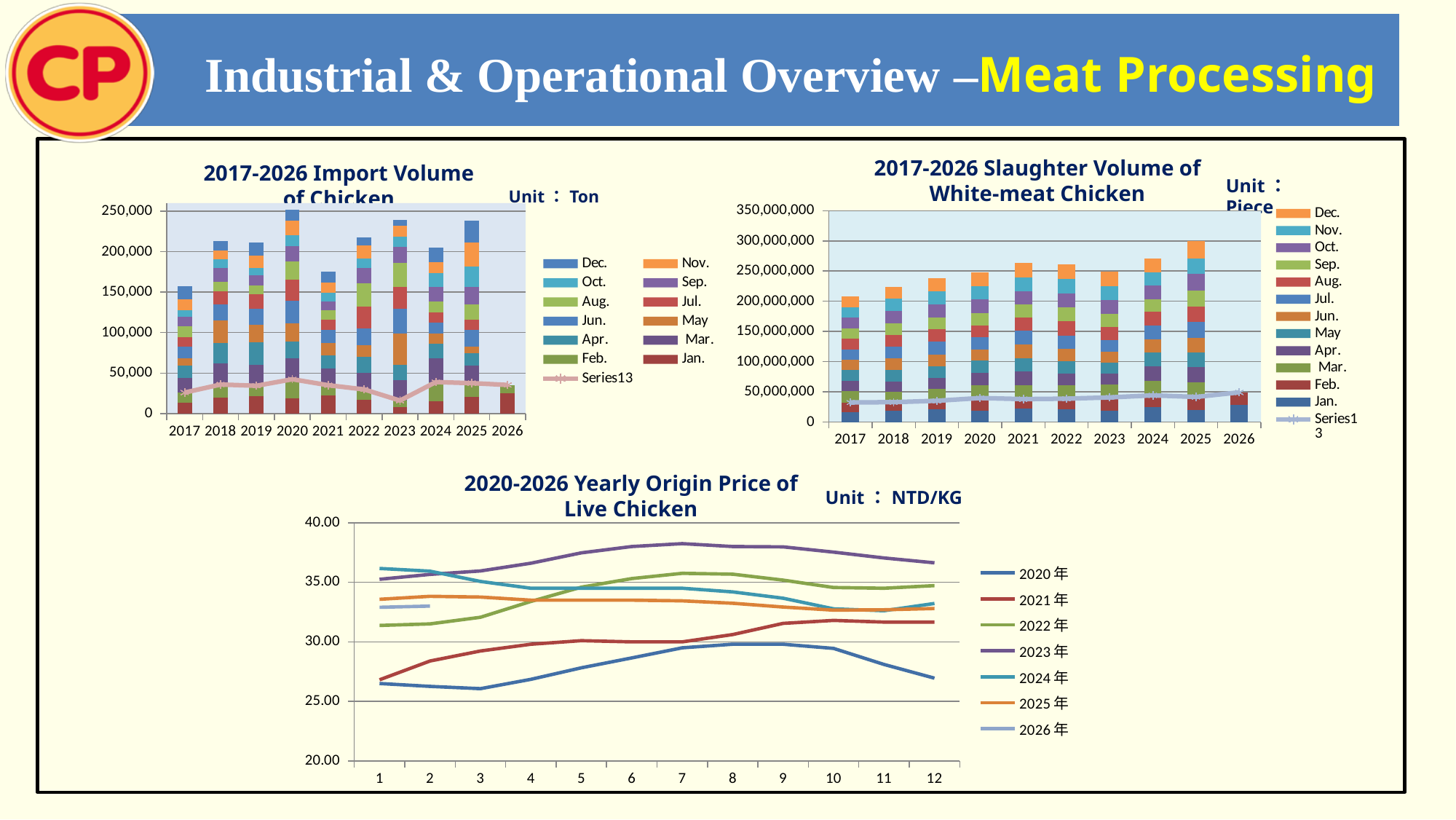
In the '2017-2026 Slaughter Volume of White-meat Chicken' chart, which year has the shortest bar? 2026 In the '2020-2026 Yearly Origin Price of Live Chicken' chart, which year's line is highest at month 7? 2023年 In the '2017-2026 Slaughter Volume of White-meat Chicken' chart, which year has the tallest bar? 2025 In the '2020-2026 Yearly Origin Price of Live Chicken' chart, does the 2021年 line generally rise or fall from month 1 to month 12? Rise In the '2017-2026 Slaughter Volume of White-meat Chicken' chart, is the total bar for 2017 greater or less than 250,000,000? less What unit is stated for the '2020-2026 Yearly Origin Price of Live Chicken' chart? NTD/KG In the '2017-2026 Import Volume of Chicken' chart, which year has the tallest bar? 2020 What kind of chart is the '2017-2026 Import Volume of Chicken' chart? Combination chart: stacked bar chart with a line series In the '2017-2026 Import Volume of Chicken' chart, is the total bar for 2021 greater or less than 200,000? less How many series does the legend of the '2020-2026 Yearly Origin Price of Live Chicken' chart list? 7 What kind of chart is the '2020-2026 Yearly Origin Price of Live Chicken' chart? Line chart In the '2017-2026 Import Volume of Chicken' chart, how many years are shown on the x axis? 10